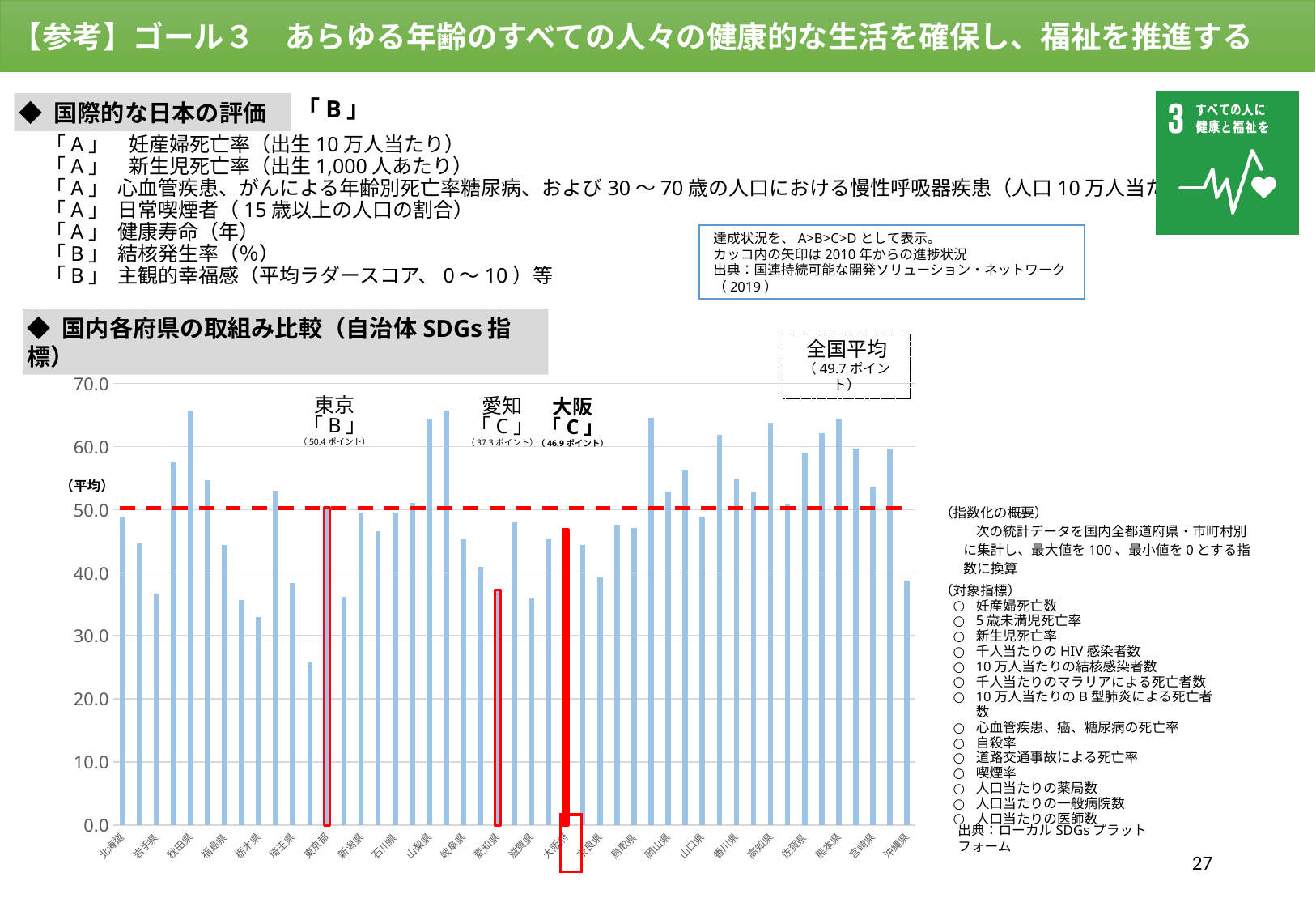
In the bar chart, how much higher is 東京's value than 大阪's value? 3.5 ポイント In the bar chart, is the value for 栃木県 greater or less than 40.0? less In the bar chart, which has the larger value, 東京 or 大阪? 東京 What is the 全国平均 value shown on the bar chart? 49.7 ポイント What grade is shown for 大阪 above the bar chart? 「C」 In the bar chart, is 大阪's value larger or smaller than the 全国平均? smaller In the bar chart comparing prefectures, what value is printed for 東京? 50.4 ポイント In the bar chart, is the value for 秋田県 greater or less than 60.0? greater In the bar chart comparing prefectures, what value is printed for 大阪? 46.9 ポイント In the bar chart, what is the difference between 大阪's value and 愛知's value? 9.6 ポイント What type of chart is used to compare the prefectures on this slide? bar chart In the bar chart comparing prefectures, what value is printed for 愛知? 37.3 ポイント